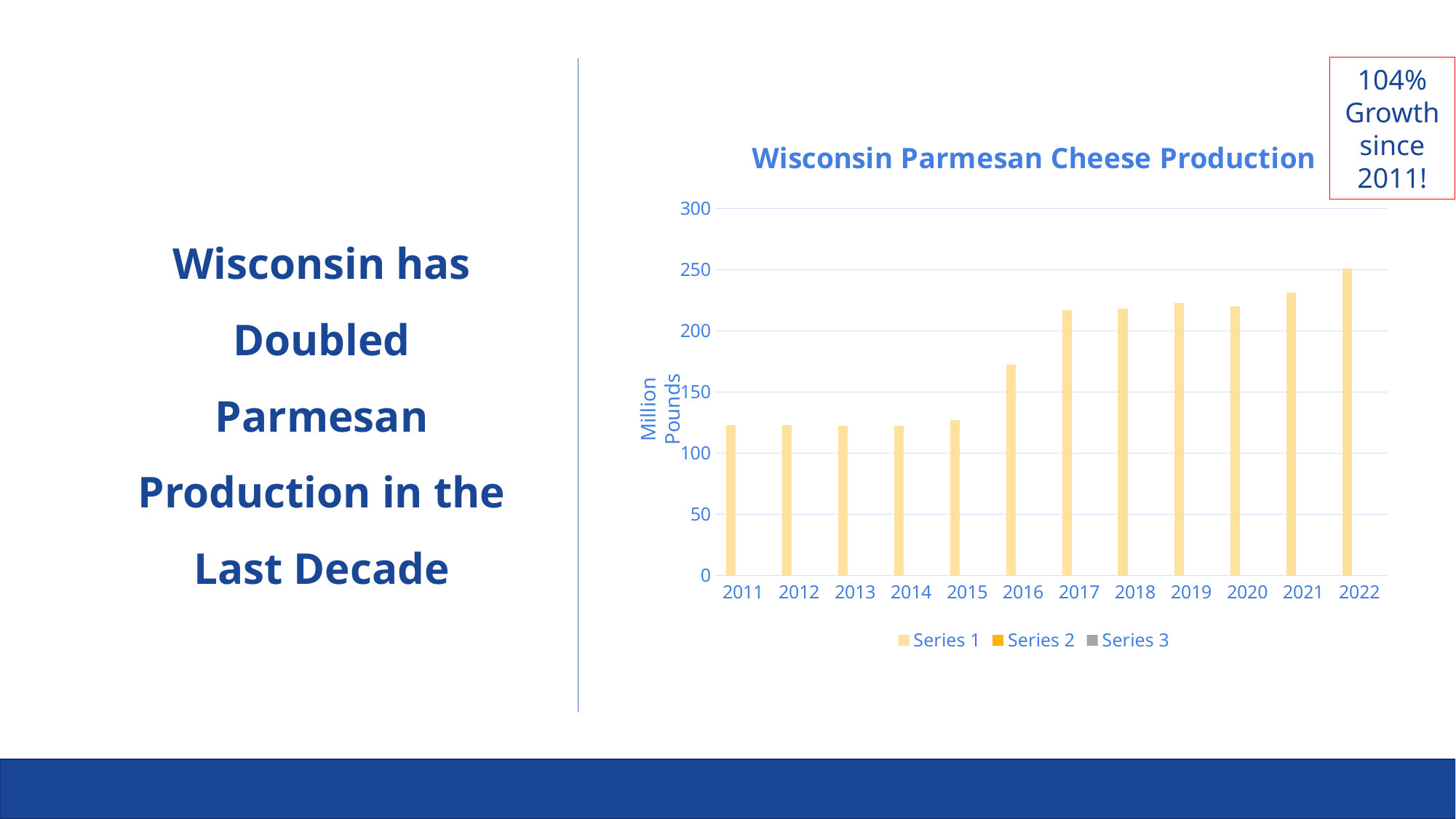
Is the value for 2022 greater or less than 200? greater Do the production values generally rise or fall from 2011 to 2022? rise Is the value for 2016 greater or less than 150? greater Which year has the larger value, 2015 or 2016? 2016 How many years are shown on the x axis of the chart? 12 What is the label on the vertical axis of the chart? Million Pounds How many series does the chart's legend list? 3 Which year has the highest production in the chart? 2022 What kind of chart is shown on the slide? bar chart Is the value for 2011 greater or less than 150? less What is the title of the chart? Wisconsin Parmesan Cheese Production